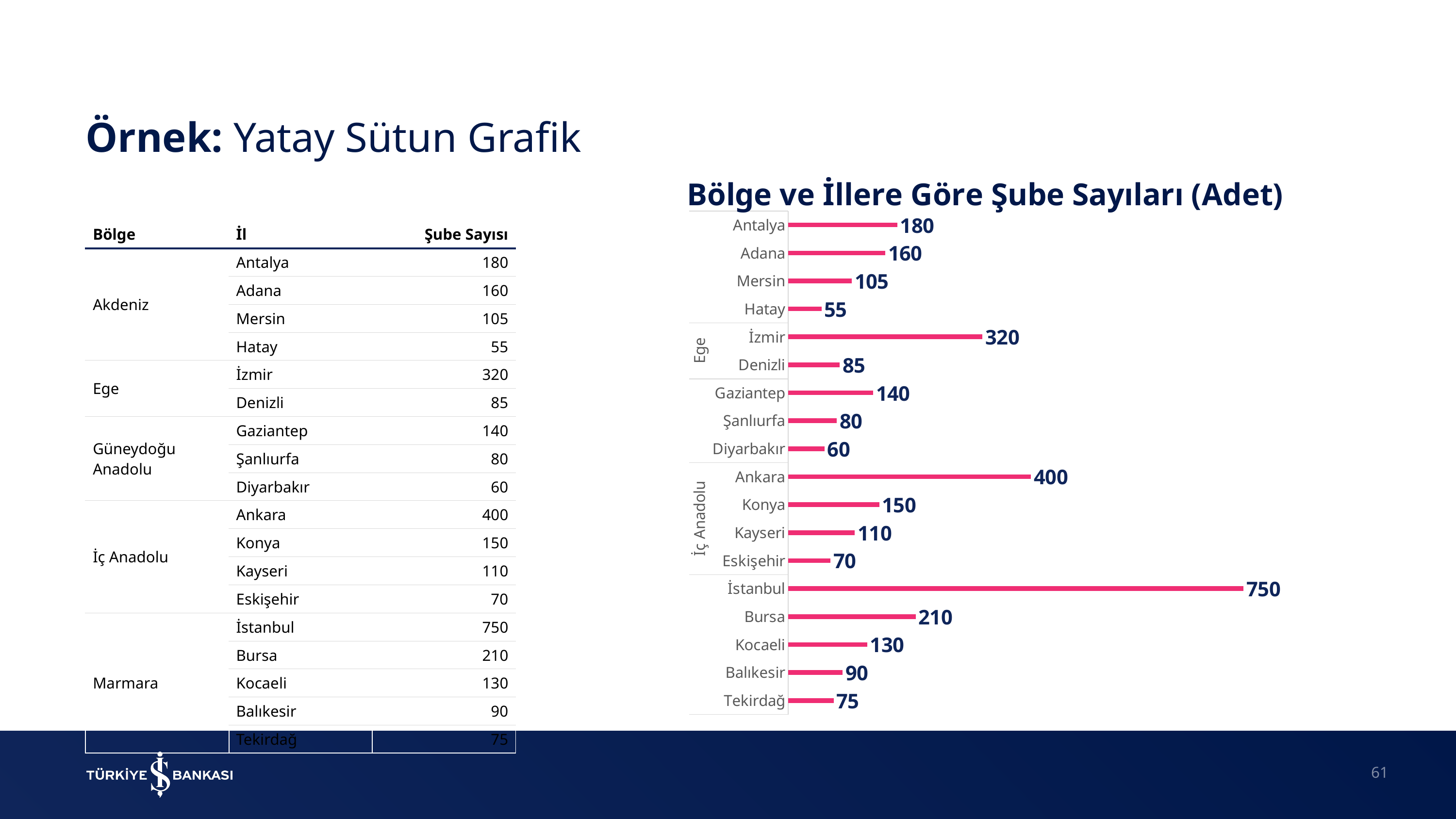
What is the value for İstanbul in the chart? 750 What is the difference between the values for Bursa and Kocaeli? 80 Which is larger, the value for Adana or the value for Konya? Adana What kind of chart is shown on the slide? Bar chart How many cities are shown in the chart? 18 What colour are the bars in the chart? Pink What is the difference between the values for Ankara and İzmir? 80 What is the title of the chart? Bölge ve İllere Göre Şube Sayıları (Adet) Which city has the highest value in the chart? İstanbul What is the value for İzmir in the chart? 320 What is the value for Gaziantep in the chart? 140 Which city has the lowest value in the chart? Hatay